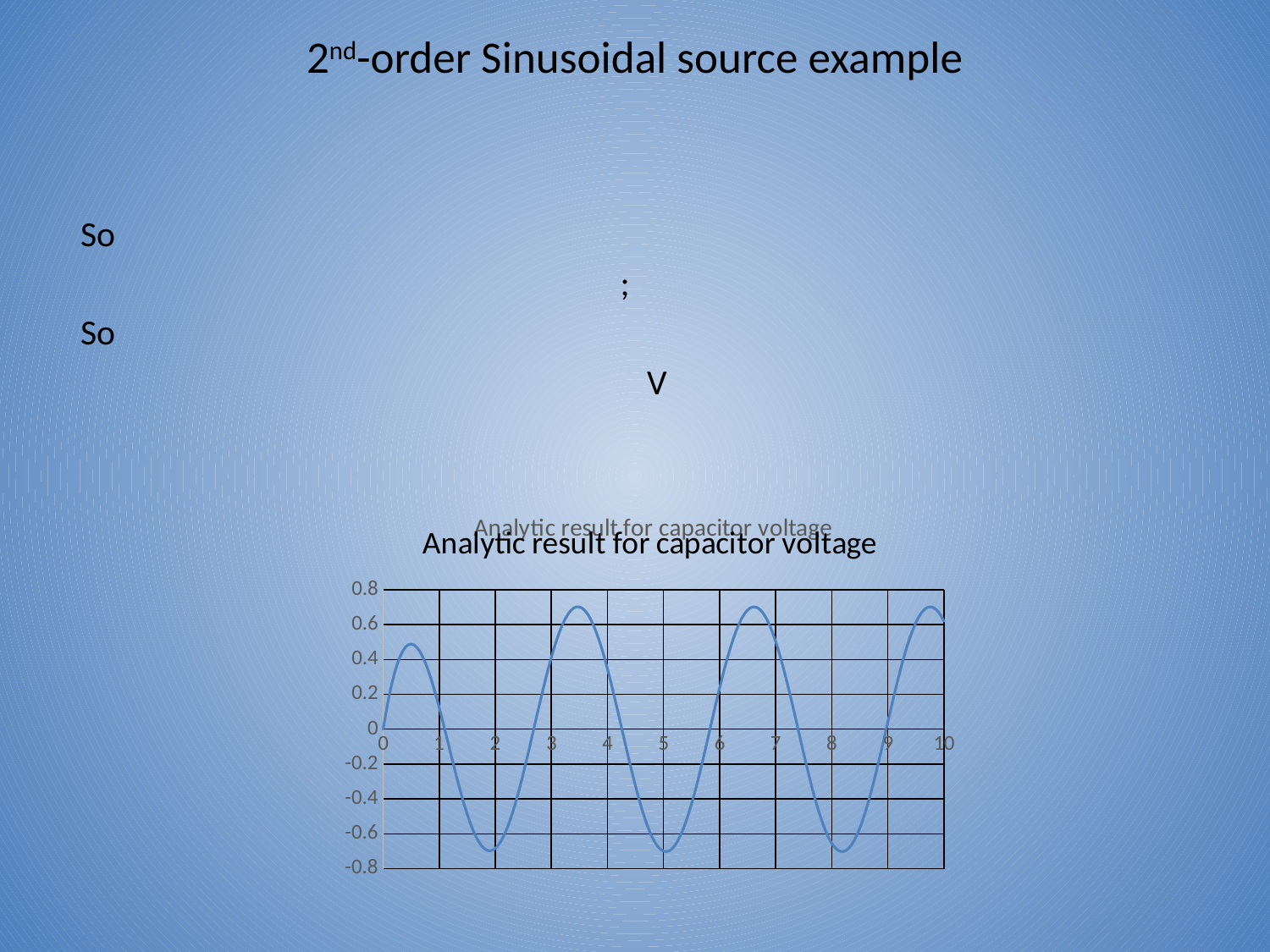
Is the trough of the curve near x = 5 greater or less than -0.4? less Is the first peak of the curve (near x = 0.5) greater or less than 0.6? less Does the curve rise or fall immediately after x = 0? rise Is the peak of the curve near x = 3.5 greater or less than 0.6? greater How many tick labels are shown on the horizontal axis? 11 What is the value of the curve at x = 0? 0 What is the highest value labelled on the vertical axis of the chart? 0.8 What is the lowest value labelled on the vertical axis of the chart? -0.8 What is the title of the chart? Analytic result for capacitor voltage What is the largest value labelled on the horizontal axis of the chart? 10 What kind of chart is shown on the slide? line chart Which is larger, the first peak of the curve (near x = 0.5) or the second peak (near x = 3.5)? the second peak